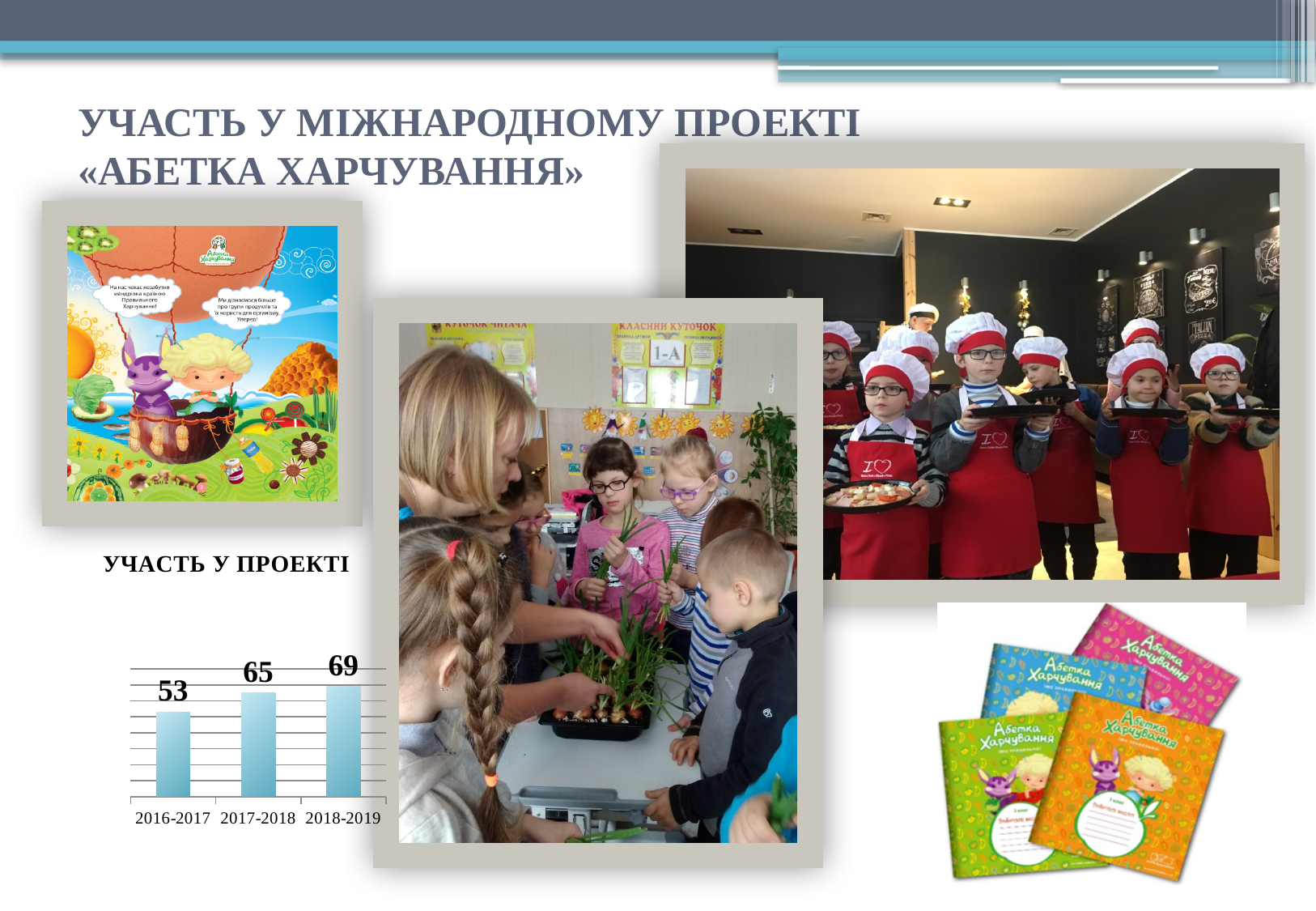
Which is larger, the value for 2017-2018 or the value for 2016-2017? 2017-2018 Which year has the lowest value in the chart? 2016-2017 How many categories are shown on the x axis of the chart? 3 What is the value for 2016-2017 in the chart? 53 What is the difference between the values for 2017-2018 and 2016-2017? 12 Which year has the highest value in the chart? 2018-2019 What is the value for 2018-2019 in the chart? 69 What is the difference between the values for 2018-2019 and 2016-2017? 16 Do the values rise or fall from 2016-2017 to 2018-2019? rise What is the title of the chart on the slide? УЧАСТЬ У ПРОЕКТІ What is the value for 2017-2018 in the chart? 65 What kind of chart is shown on the slide? bar chart